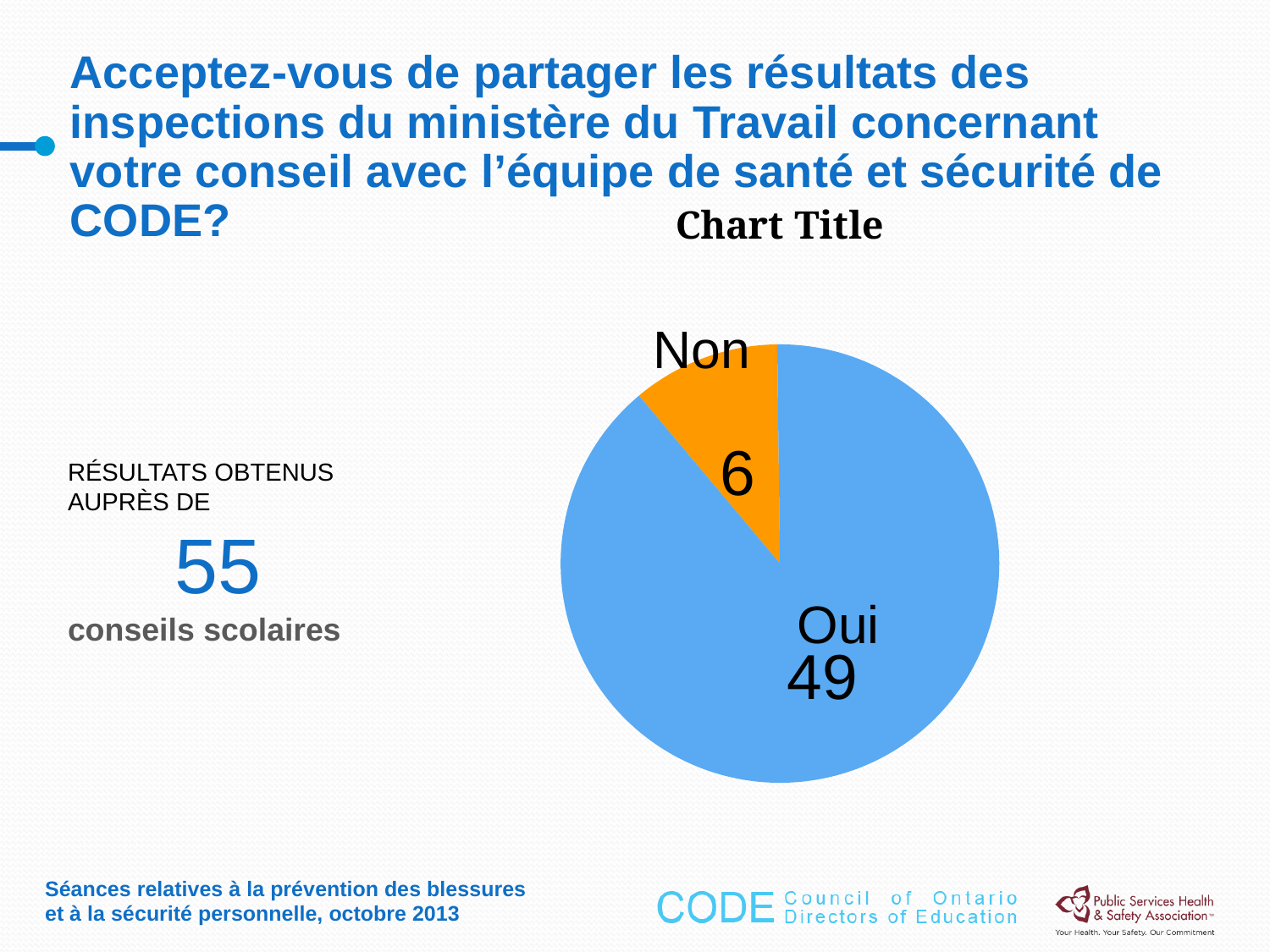
What is the value for Oui in the pie chart? 49 What is the difference between the Oui and Non values? 43 What is the value for Non in the pie chart? 6 Which slice of the pie chart is the largest? Oui How many slices does the pie chart have? 2 What is the total of the two slices in the pie chart? 55 Which is larger, Oui or Non? Oui What kind of chart is shown on the slide? pie chart What colour is the Non slice of the pie chart? orange Which slice of the pie chart is the smallest? Non What is the title shown above the pie chart? Chart Title